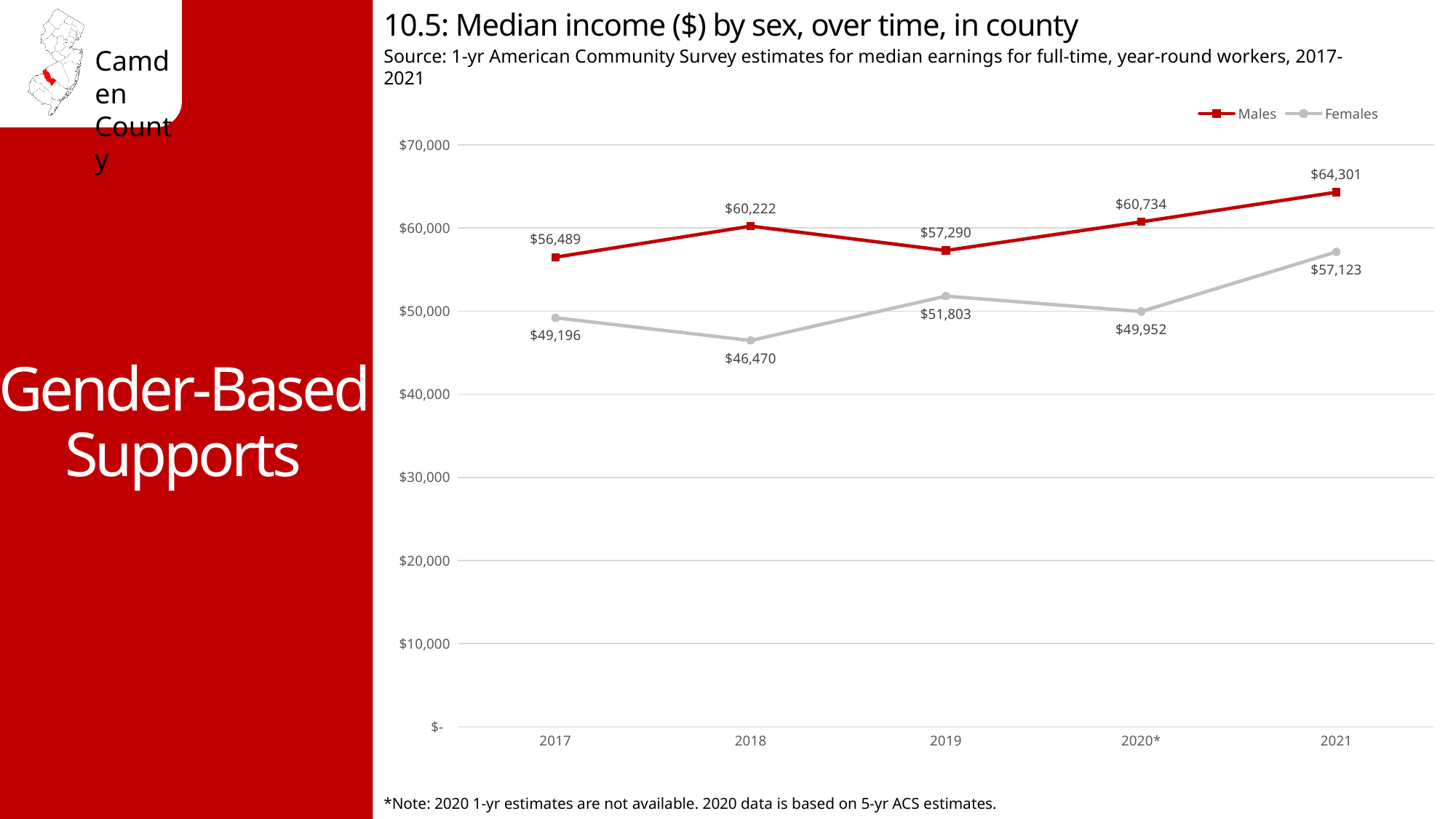
What is the difference between male median income in 2018 and 2019? $2,932 What is the difference between male and female median income in 2021? $7,178 In which year was the median income for males highest? 2021 Is the median income for females in 2017 greater or less than $50,000? less What kind of chart is shown on the slide? Line chart What was the median income for females in 2021? $57,123 Which was higher in 2019, the median income for males or for females? Males What was the median income for males in 2018? $60,222 In which year was the median income for females lowest? 2018 How many series does the legend list? 2 What was the median income for females in 2020*? $49,952 How many years are shown on the x axis? 5